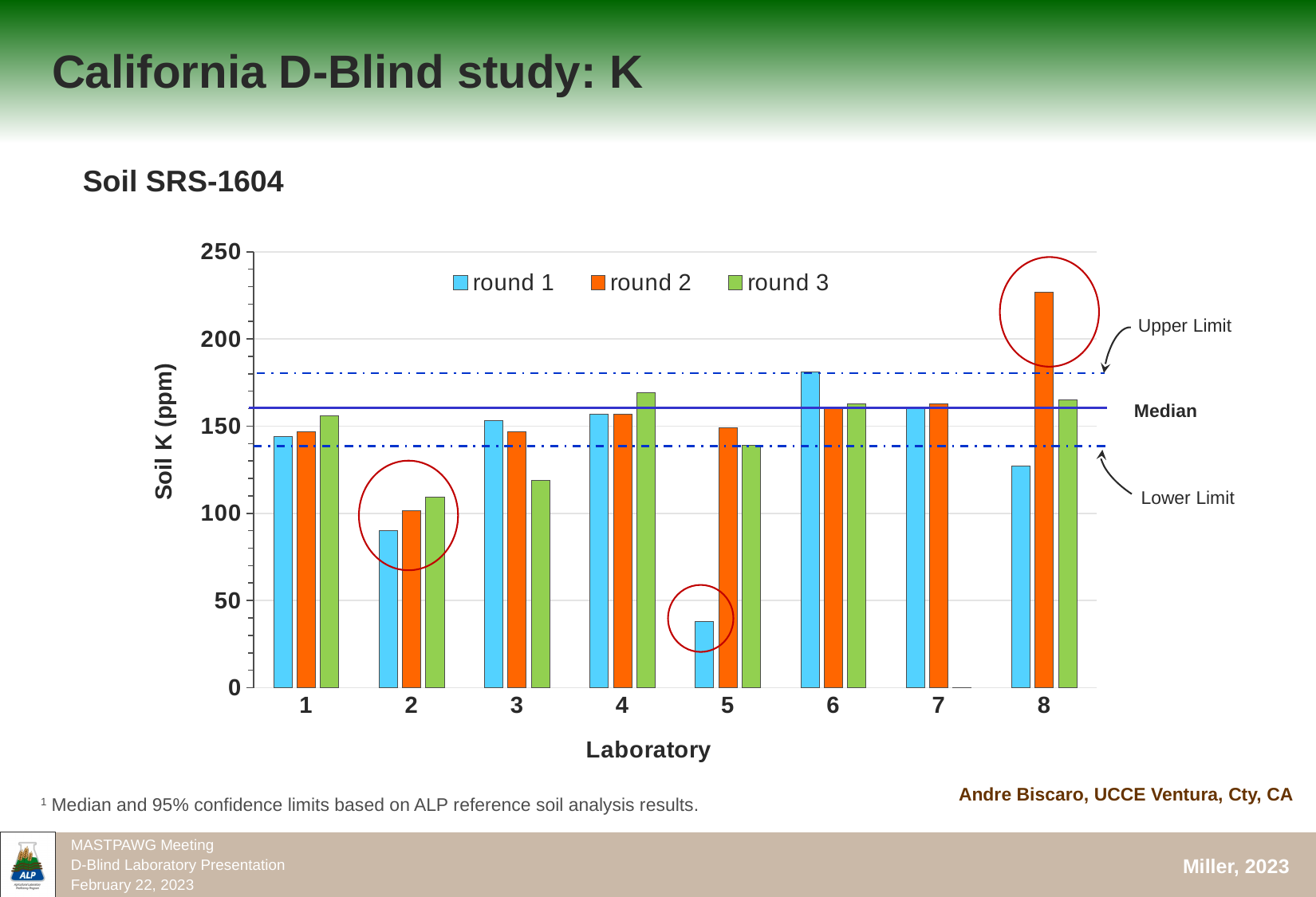
For laboratory 3, which is larger: the round 1 value or the round 3 value? round 1 Is the round 1 value for laboratory 2 greater or less than 100? less Is the round 2 value for laboratory 8 greater or less than 200? greater What is the title of the y axis? Soil K (ppm) Which laboratory has the lowest round 1 value? Laboratory 5 How many laboratories are shown on the x axis? 8 What kind of chart is shown on the slide? bar chart Which laboratory and round has the highest Soil K value? Laboratory 8, round 2 Is the round 1 value for laboratory 5 greater or less than 50? less For laboratory 5, which is larger: the round 1 value or the round 2 value? round 2 How many series does the chart legend list? 3